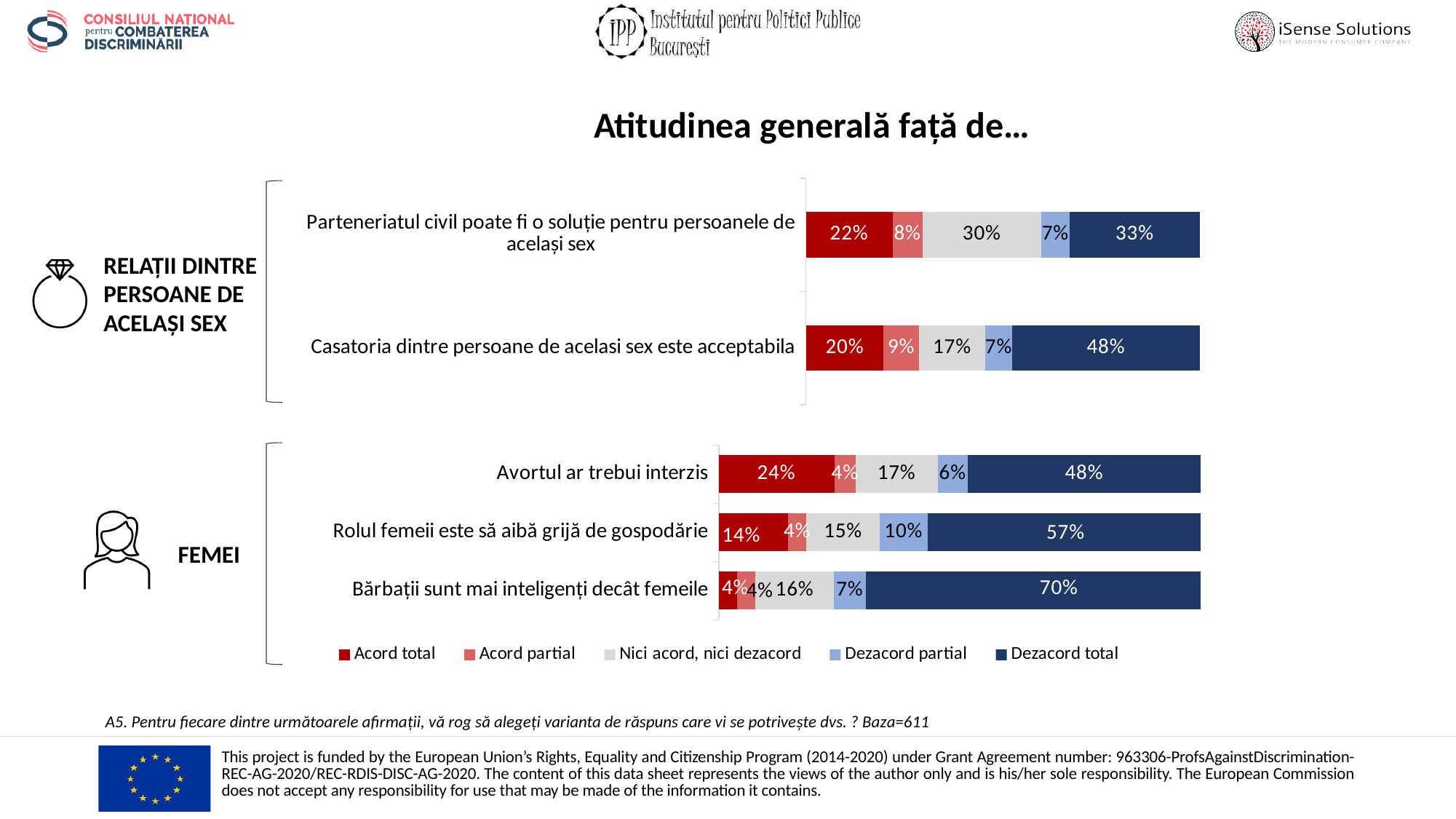
In the bottom chart (Femei), which statement has the highest 'Acord total' value? Avortul ar trebui interzis In the bottom chart (Femei), what is the 'Dezacord total' value for 'Bărbații sunt mai inteligenți decât femeile'? 70% In the bottom chart (Femei), what is the 'Nici acord, nici dezacord' value for 'Rolul femeii este să aibă grijă de gospodărie'? 15% In the bottom chart (Femei), what is the combined 'Acord total' and 'Acord partial' value for 'Avortul ar trebui interzis'? 28% How many series does the legend list? 5 In the bottom chart (Femei), which statement has the lowest 'Dezacord total' value? Avortul ar trebui interzis How many statements are plotted in the bottom chart (Femei)? 3 In the top chart (Relații dintre persoane de același sex), what is the difference between the 'Dezacord total' values for 'Casatoria dintre persoane de acelasi sex este acceptabila' and 'Parteneriatul civil poate fi o soluție pentru persoanele de același sex'? 15% In the bottom chart (Femei), which is larger: the 'Dezacord partial' value for 'Rolul femeii este să aibă grijă de gospodărie' or for 'Avortul ar trebui interzis'? Rolul femeii este să aibă grijă de gospodărie What kind of chart is used on this slide? Stacked bar chart In the top chart (Relații dintre persoane de același sex), what is the 'Acord total' value for 'Parteneriatul civil poate fi o soluție pentru persoanele de același sex'? 22% In the top chart (Relații dintre persoane de același sex), what is the 'Dezacord total' value for 'Casatoria dintre persoane de acelasi sex este acceptabila'? 48%